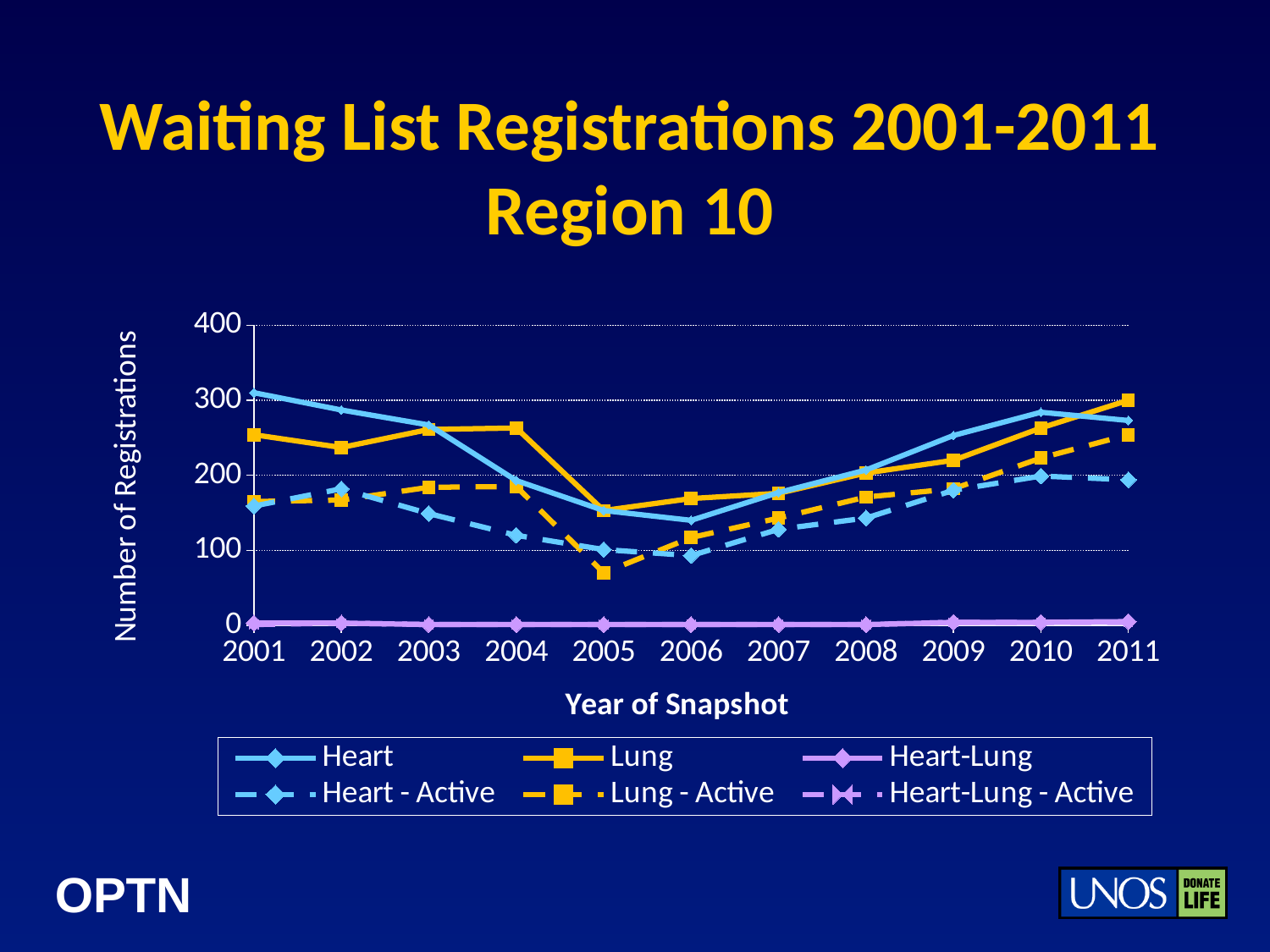
How many series does the legend list? 6 How many years are plotted along the x axis? 11 What is the title of the y axis? Number of Registrations In which year is the Lung series at its highest? 2011 Is the value for Heart-Lung in 2005 greater or less than 100? less Is the value for Lung in 2004 greater or less than 200? greater In which year is the Heart series at its highest? 2001 Is the value for Heart in 2006 greater or less than 200? less In which year is the Lung - Active series at its lowest? 2005 Does the Heart series rise or fall from 2001 to 2006? Fall In 2001, which is larger, Heart or Lung? Heart What kind of chart is shown on the slide? Line chart